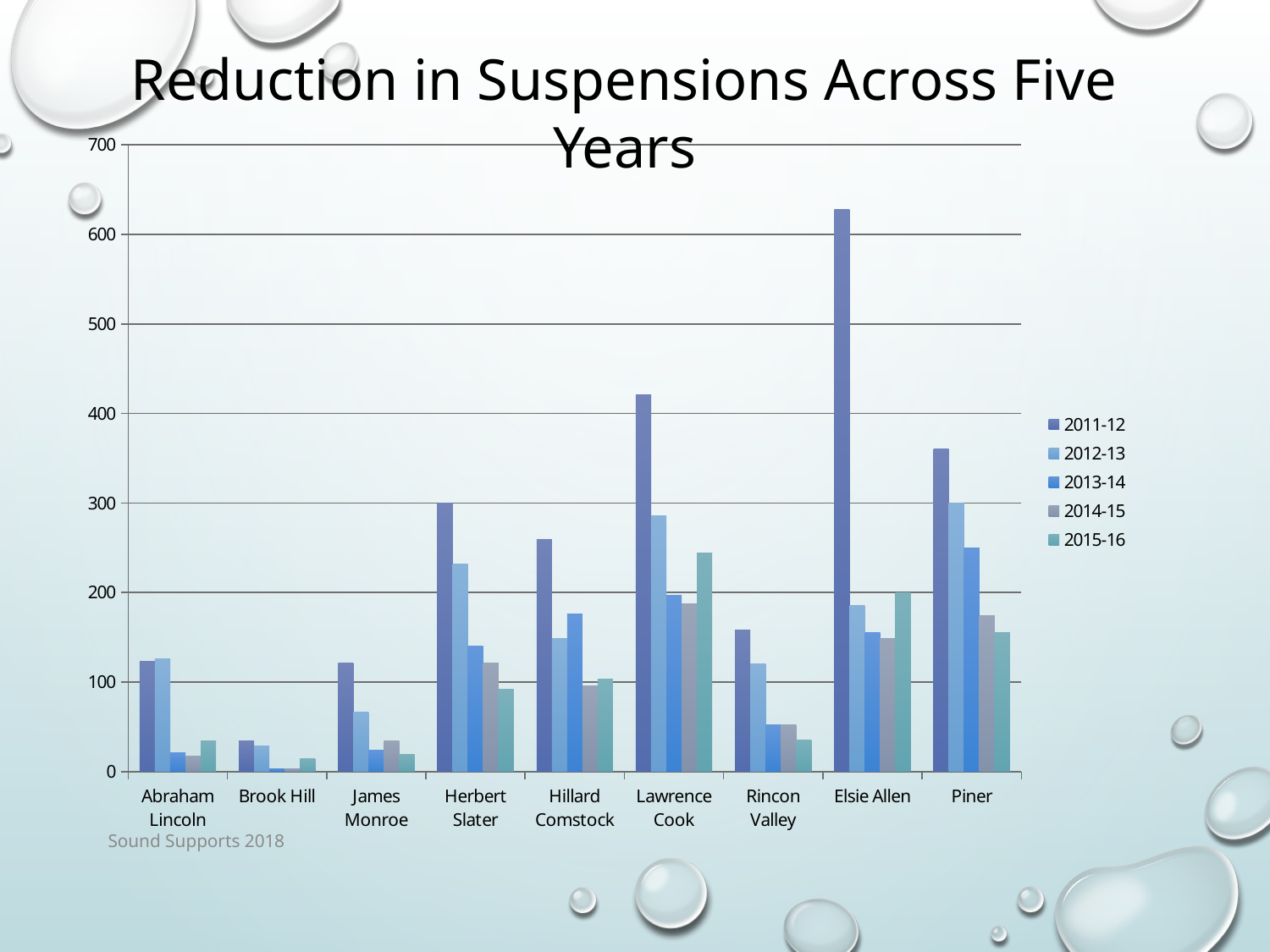
Which school has the highest 2011-12 value? Elsie Allen How many series does the legend list? 5 What is the title of the chart? Reduction in Suspensions Across Five Years Which is larger, the 2011-12 value for Lawrence Cook or the 2011-12 value for Piner? Lawrence Cook Is the 2011-12 value for Rincon Valley greater or less than 100? greater Is the 2015-16 value for Abraham Lincoln greater or less than 100? less What kind of chart is shown on the slide? bar chart Which school has the lowest 2011-12 value? Brook Hill Is the 2011-12 value for Lawrence Cook greater or less than 400? greater For Piner, do the values rise or fall from 2011-12 to 2015-16? fall How many schools (categories) are shown on the x axis? 9